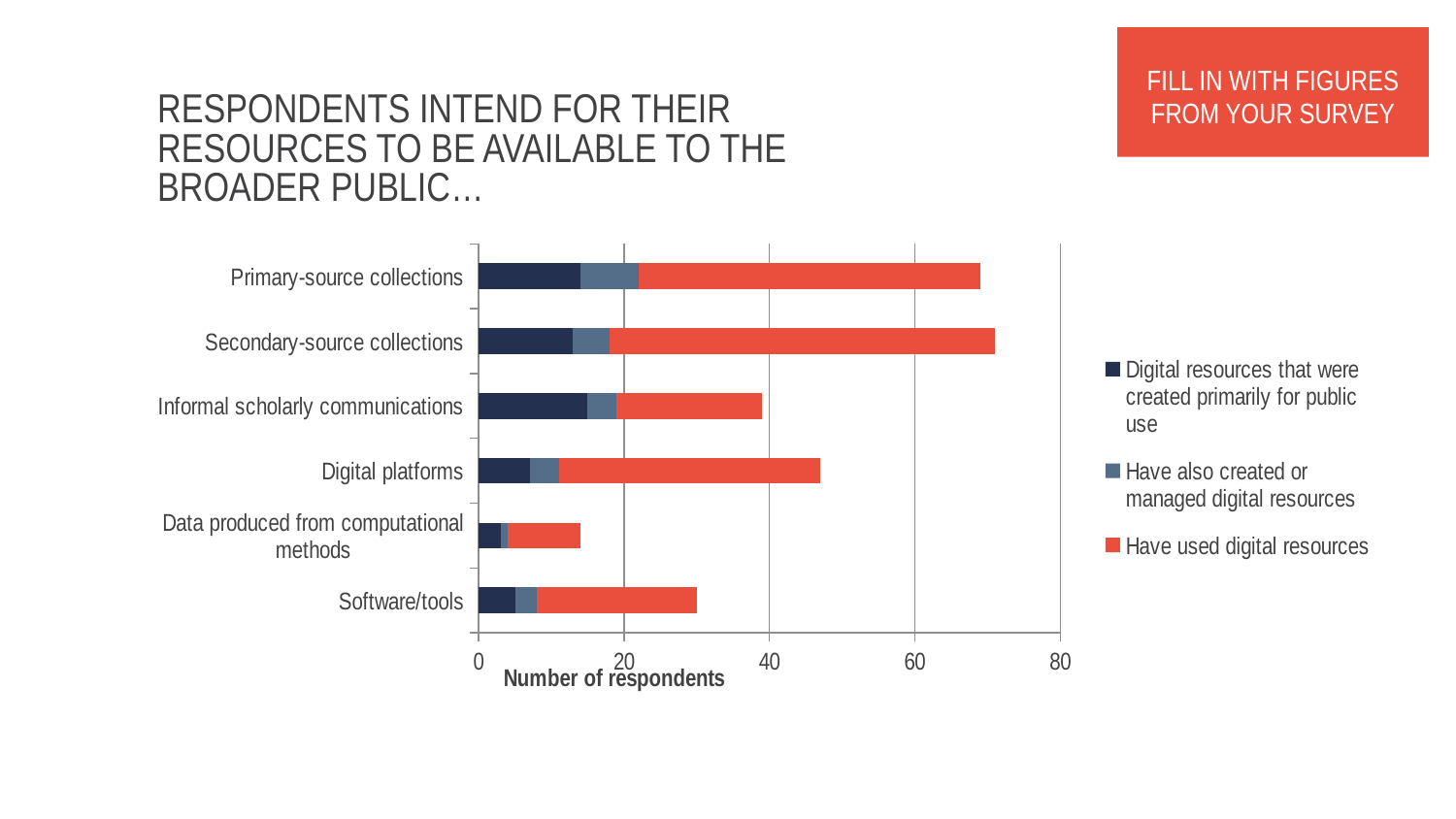
Is the total value for Software/tools greater or less than 20? greater Which has a larger total: Digital platforms or Informal scholarly communications? Digital platforms How many categories are plotted on the chart? 6 Is the total value for Data produced from computational methods greater or less than 20? less Which has a larger total: Software/tools or Data produced from computational methods? Software/tools Is the total value for Primary-source collections greater or less than 60? greater How many series does the legend list? 3 What kind of chart is shown on the slide? bar chart Which category has the lowest total number of respondents? Data produced from computational methods What is the title of the horizontal axis? Number of respondents